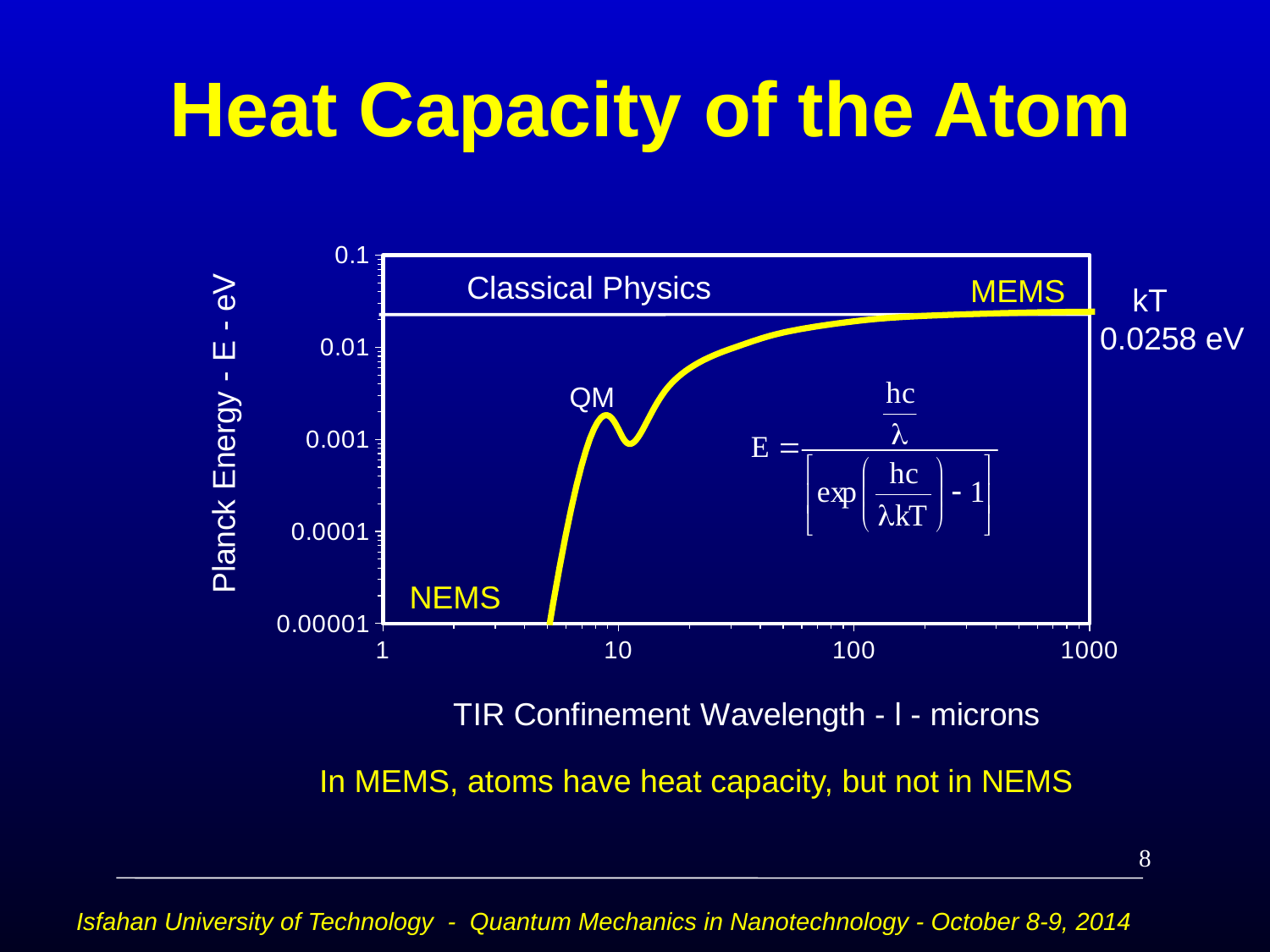
What is the highest tick value shown on the x axis? 1000 What is the label of the x axis? TIR Confinement Wavelength - l - microns Does the Planck energy curve rise or fall as the TIR confinement wavelength increases from 1 to 1000 microns? rise How many curves are plotted on the chart? 1 Which region label appears at the bottom left of the plot area? NEMS Is the Planck energy at a wavelength of 1000 microns greater or less than 0.01 eV? greater Is the Planck energy at a wavelength of 100 microns greater or less than 0.01 eV? greater What is the value of kT marked on the chart? 0.0258 eV What is the label of the y axis? Planck Energy - E - eV Is the Planck energy at a wavelength of 1000 microns greater or less than 0.1 eV? less What is the lowest tick value shown on the y axis? 0.00001 What kind of chart is shown on the slide? line chart